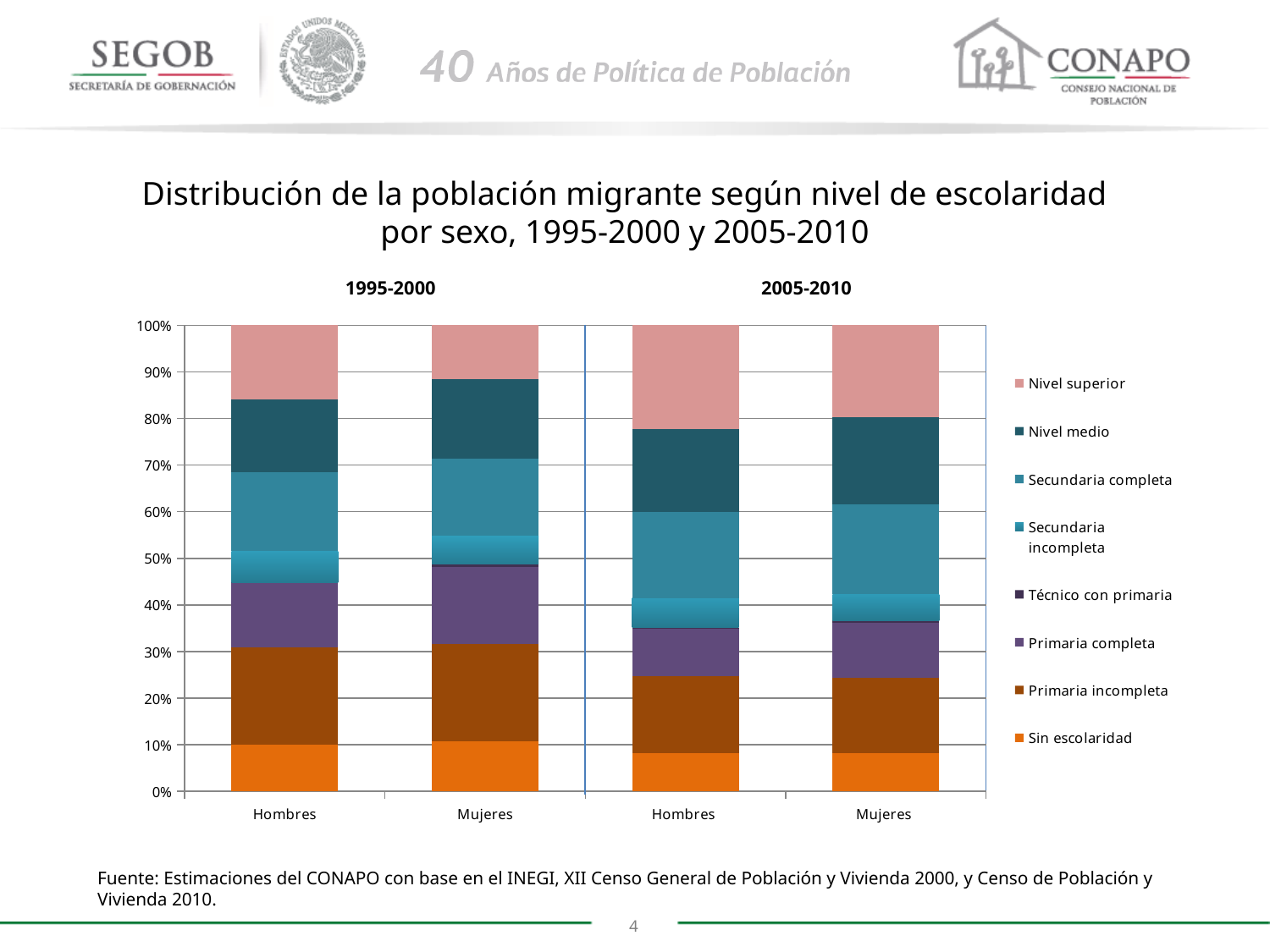
Which has the larger Primaria incompleta share: Hombres in 1995-2000 or Hombres in 2005-2010? Hombres in 1995-2000 What kind of chart is shown on the slide? Stacked bar chart What is the total height of each stacked bar? 100% Is the Nivel superior share for Hombres in 1995-2000 greater or less than 20%? less How many stacked bars are plotted in the chart? 4 Which two periods are compared in the chart? 1995-2000 and 2005-2010 How many series does the legend list? 8 Is the cumulative share up to Primaria completa for Hombres in 1995-2000 greater or less than 40%? greater From 1995-2000 to 2005-2010, does the Nivel superior share rise or fall for both sexes? rise Is the Sin escolaridad share for Hombres in 2005-2010 greater or less than 20%? less Which has the larger Nivel superior share: Hombres in 1995-2000 or Hombres in 2005-2010? Hombres in 2005-2010 Which legend entry is shown at the bottom of each stacked bar? Sin escolaridad